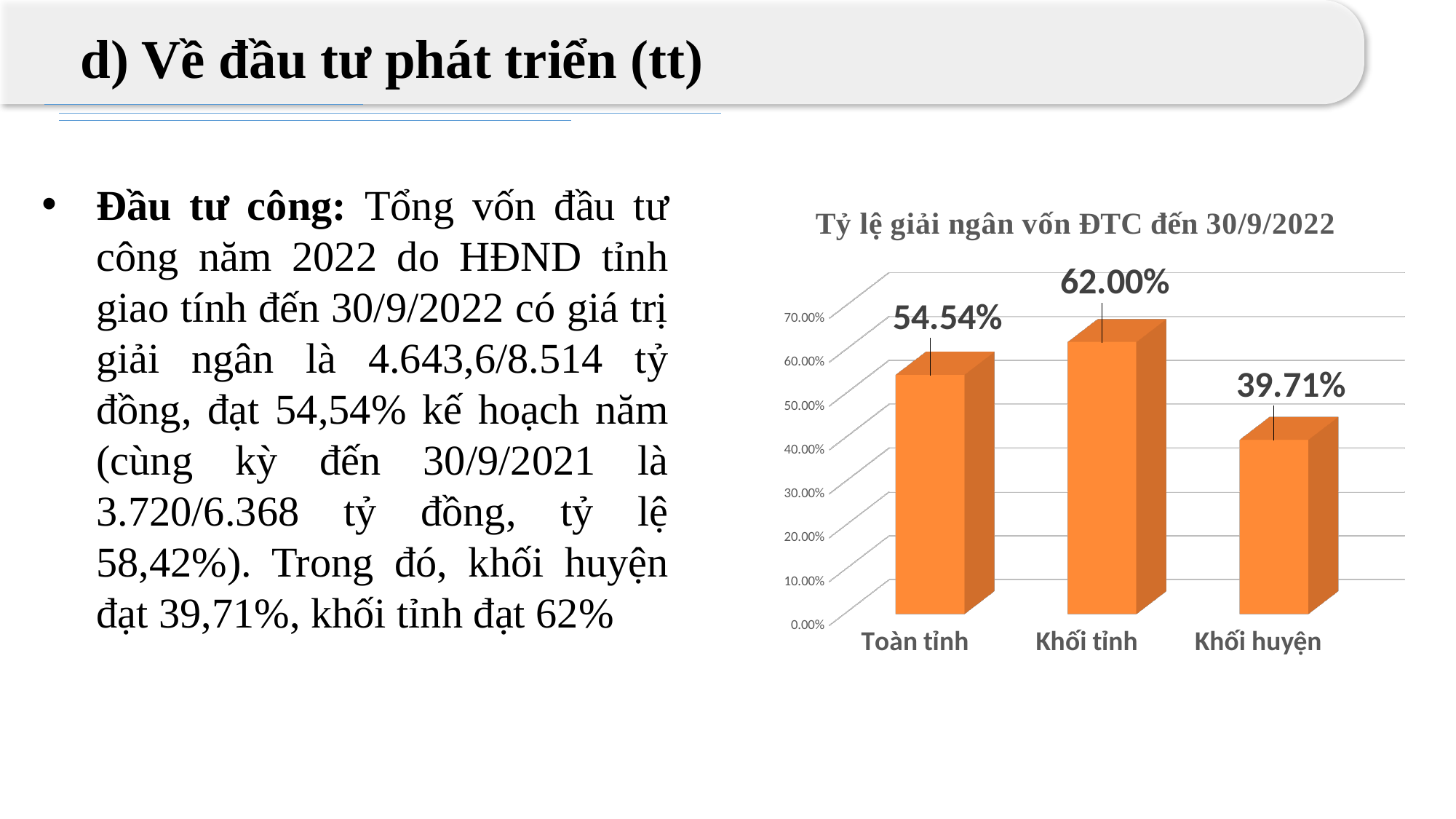
Which category has the highest value? Khối tỉnh What is the title of the chart? Tỷ lệ giải ngân vốn ĐTC đến 30/9/2022 What is the value for Khối tỉnh? 62.00% What is the difference between the values for Khối tỉnh and Toàn tỉnh? 7.46% Which is larger, the value for Toàn tỉnh or the value for Khối huyện? Toàn tỉnh What is the value for Toàn tỉnh? 54.54% What is the difference between the values for Khối tỉnh and Khối huyện? 22.29% Is the value for Khối huyện greater or less than 40.00%? less What kind of chart is shown on the slide? bar chart Which category has the lowest value? Khối huyện How many categories are shown on the chart? 3 What is the value for Khối huyện? 39.71%